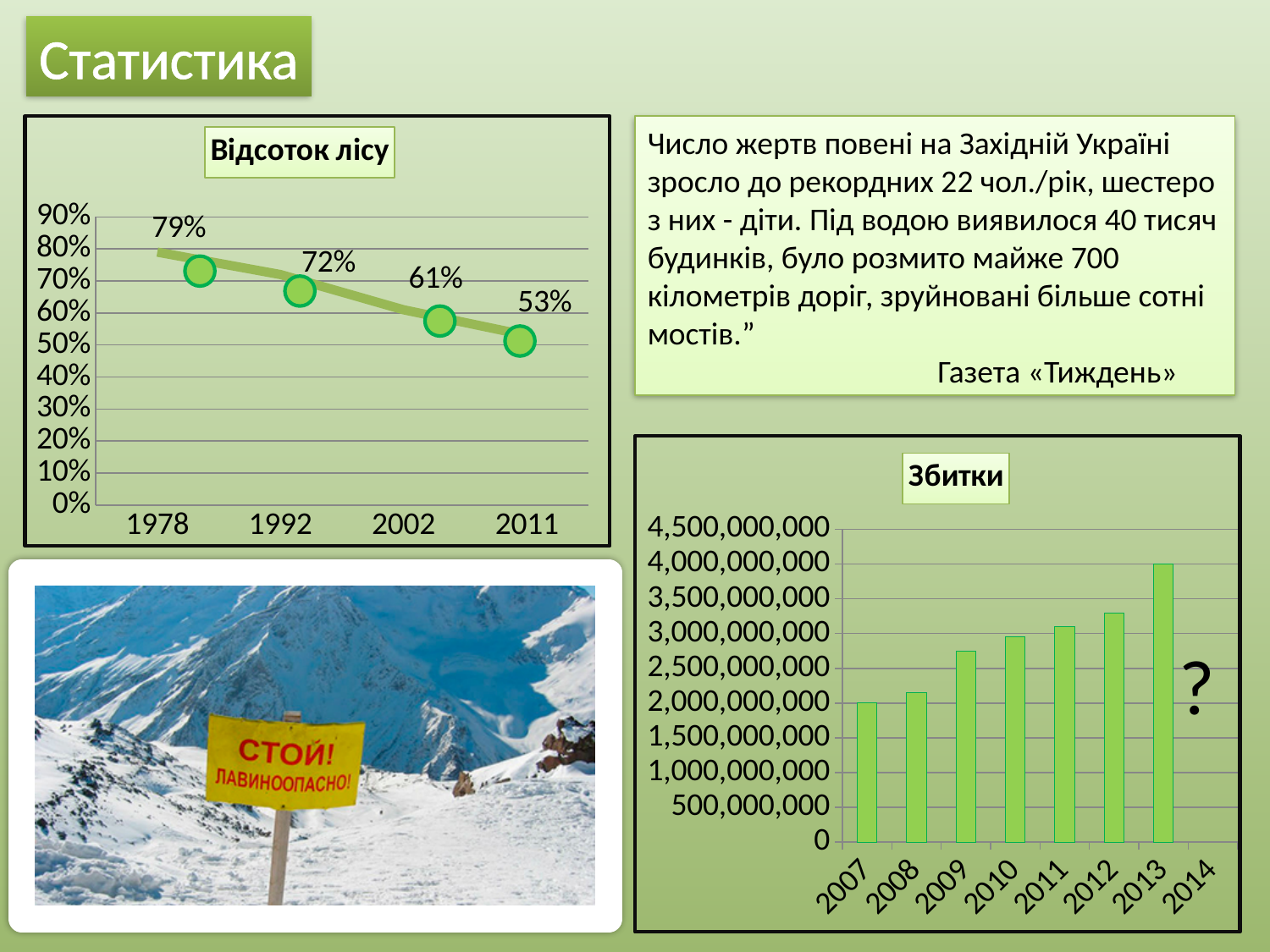
In the 'Відсоток лісу' chart, do the values rise or fall from 1978 to 2011? fall In the 'Збитки' chart, which year has the tallest bar? 2013 In the 'Збитки' chart, is the value for 2008 greater or less than 2,500,000,000? less How many data points are plotted in the 'Відсоток лісу' chart? 4 In the 'Відсоток лісу' chart, what is the value for 1978? 79% What kind of chart is the 'Збитки' chart? bar chart In the 'Відсоток лісу' chart, what is the difference between the values for 1992 and 2011? 19% In the 'Відсоток лісу' chart, what is the value for 2011? 53% In the 'Збитки' chart, is the value for 2012 greater or less than 3,000,000,000? greater In the 'Відсоток лісу' chart, which year has the highest value? 1978 In the 'Відсоток лісу' chart, what is the value for 2002? 61% In the 'Збитки' chart, which year is marked with a question mark instead of a bar? 2014